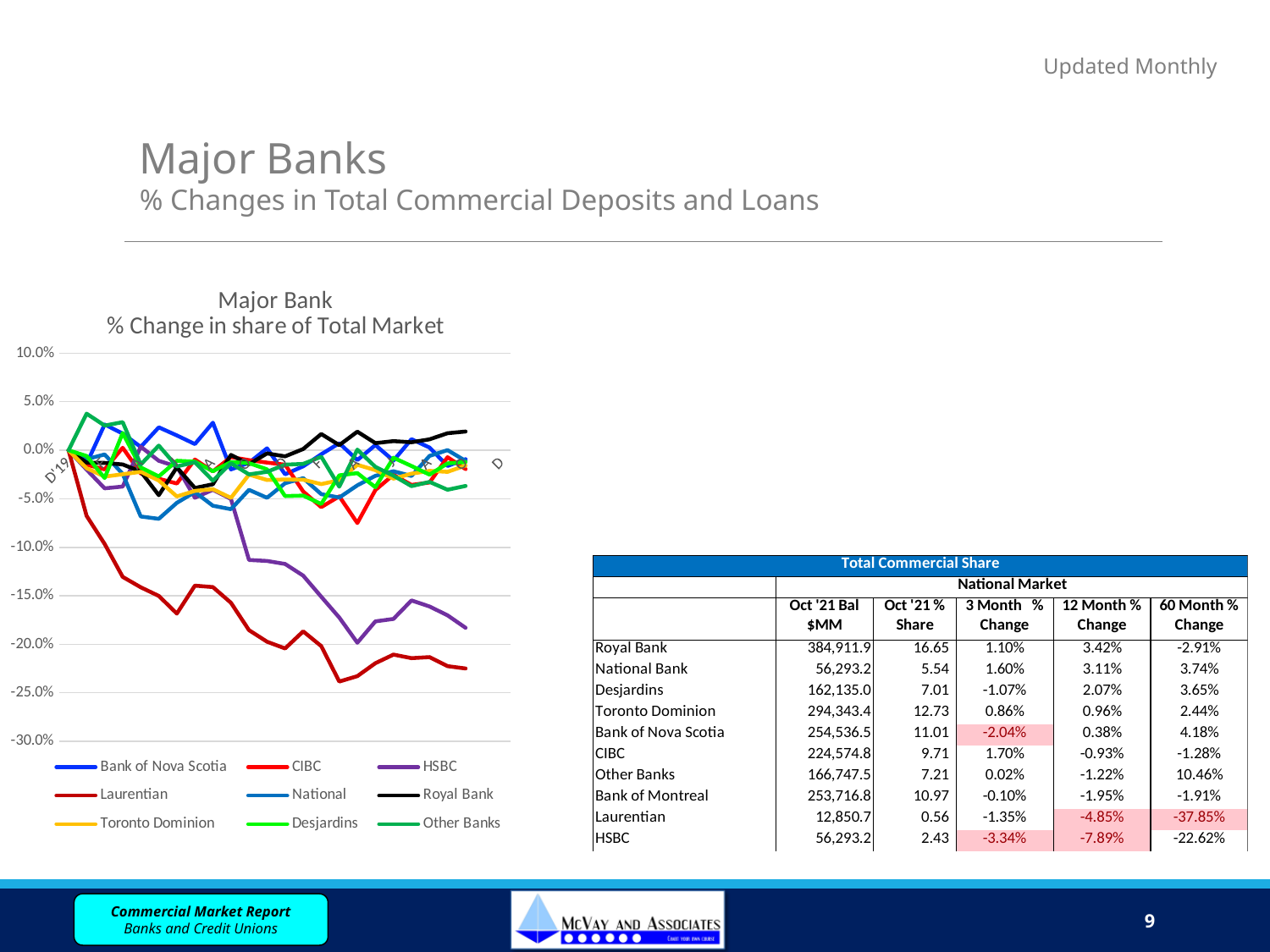
Which series reaches the lowest value on the chart? Laurentian What is the title of the chart? Major Bank % Change in share of Total Market How many series does the chart's legend list? 9 Which series is highest at the right end of the chart? Royal Bank Does the Laurentian line generally rise or fall from left to right? Fall Is the value for HSBC at the right end of the chart greater or less than -20.0%? greater At the right end of the chart, which is lower: Laurentian or HSBC? Laurentian What kind of chart is shown on the slide? Line chart What is the lowest value shown on the chart's vertical axis? -30.0% Is the value for Laurentian at the right end of the chart greater or less than -20.0%? less Is the value for Royal Bank at the right end of the chart greater or less than 0.0%? greater